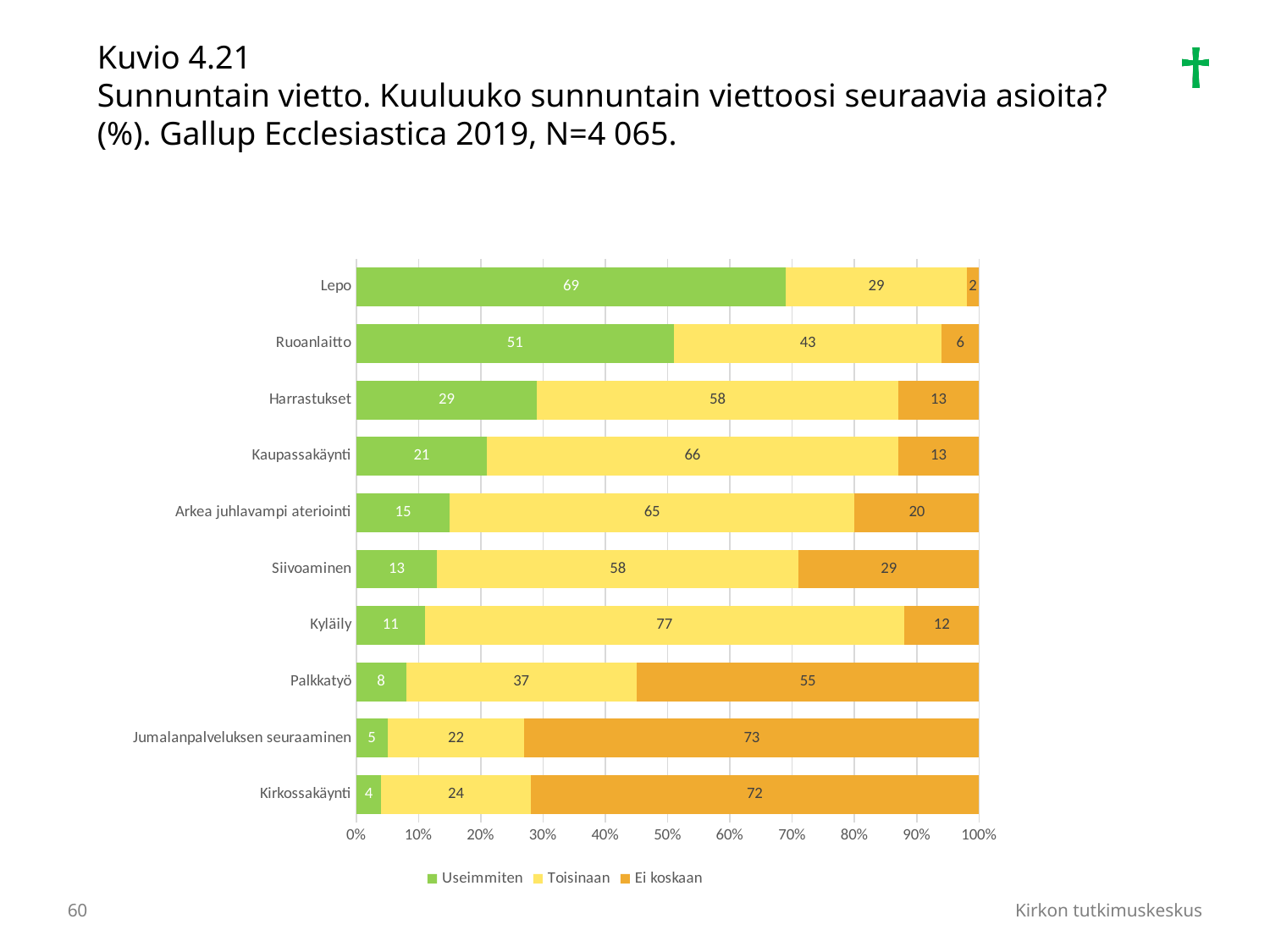
What is the 'Ei koskaan' value for Jumalanpalveluksen seuraaminen? 73 Which category has the lowest 'Useimmiten' value? Kirkossakäynti What is the 'Useimmiten' value for Lepo? 69 What is the 'Toisinaan' value for Kyläily? 77 What is the total of the stacked bar for Ruoanlaitto? 100 How many series does the legend list? 3 Which series is shown in green in the legend? Useimmiten What kind of chart is shown on the slide? Stacked bar chart Which category has the highest 'Useimmiten' value? Lepo How many categories are shown on the chart? 10 What is the difference between the 'Ei koskaan' values for Palkkatyö and Siivoaminen? 26 Which is larger: the 'Toisinaan' value for Ruoanlaitto or for Harrastukset? Harrastukset